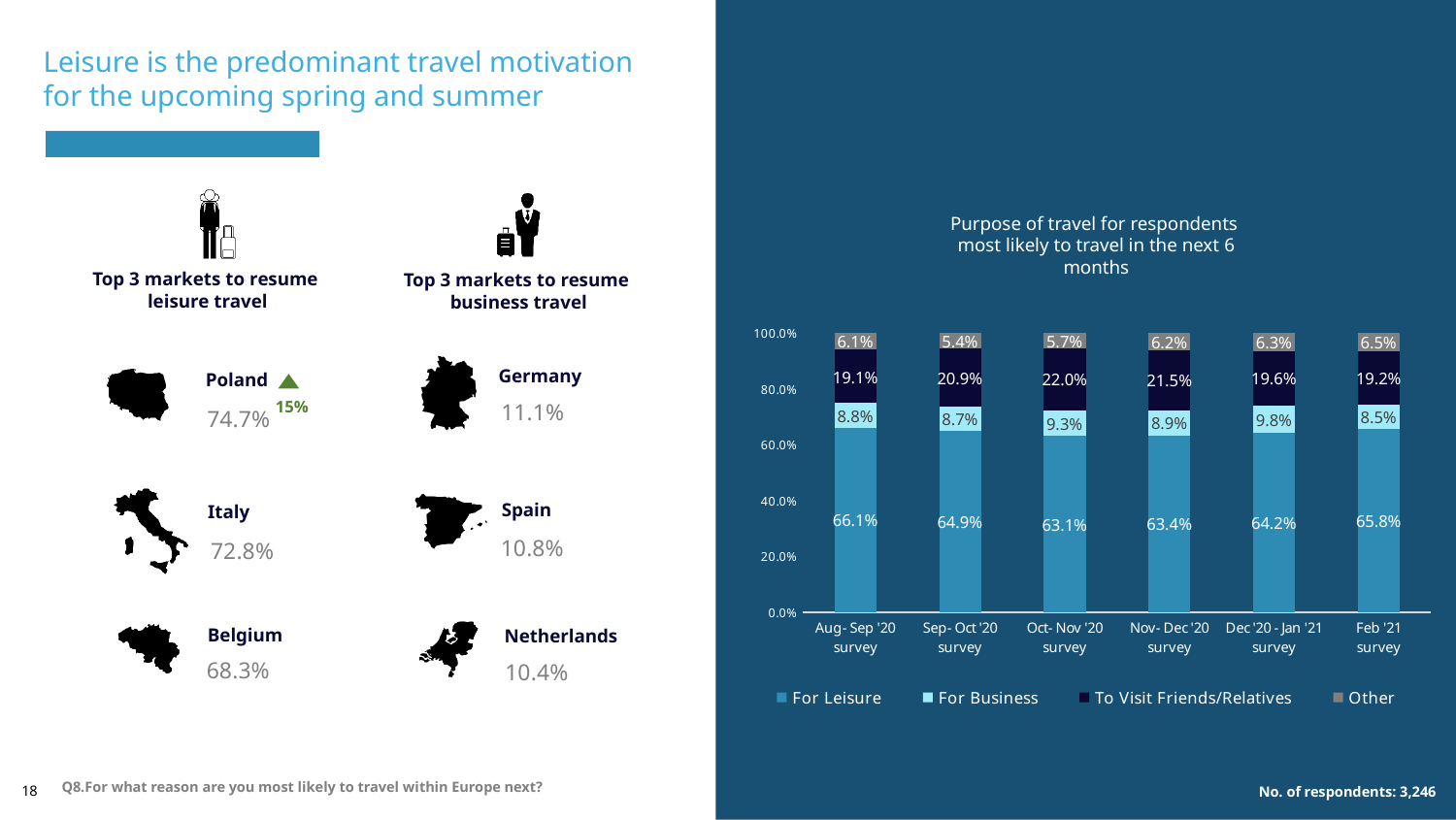
What is the value for 'For Business' in the Dec '20 - Jan '21 survey? 9.8% How many survey periods are shown on the x axis? 6 In which survey is the 'To Visit Friends/Relatives' share highest? Oct-Nov '20 survey How many series does the legend list? 4 In which survey is the 'For Leisure' share highest? Aug-Sep '20 survey What is the value for 'Other' in the Sep-Oct '20 survey? 5.4% What is the value for 'To Visit Friends/Relatives' in the Oct-Nov '20 survey? 22.0% What is the value for 'For Leisure' in the Feb '21 survey? 65.8% Which survey has the larger 'For Business' value, Oct-Nov '20 or Nov-Dec '20? Oct-Nov '20 survey What is the difference between the 'To Visit Friends/Relatives' value in the Oct-Nov '20 survey and the Aug-Sep '20 survey? 2.9 percentage points What kind of chart is shown on the slide? Stacked bar chart In which survey is the 'For Leisure' share lowest? Oct-Nov '20 survey